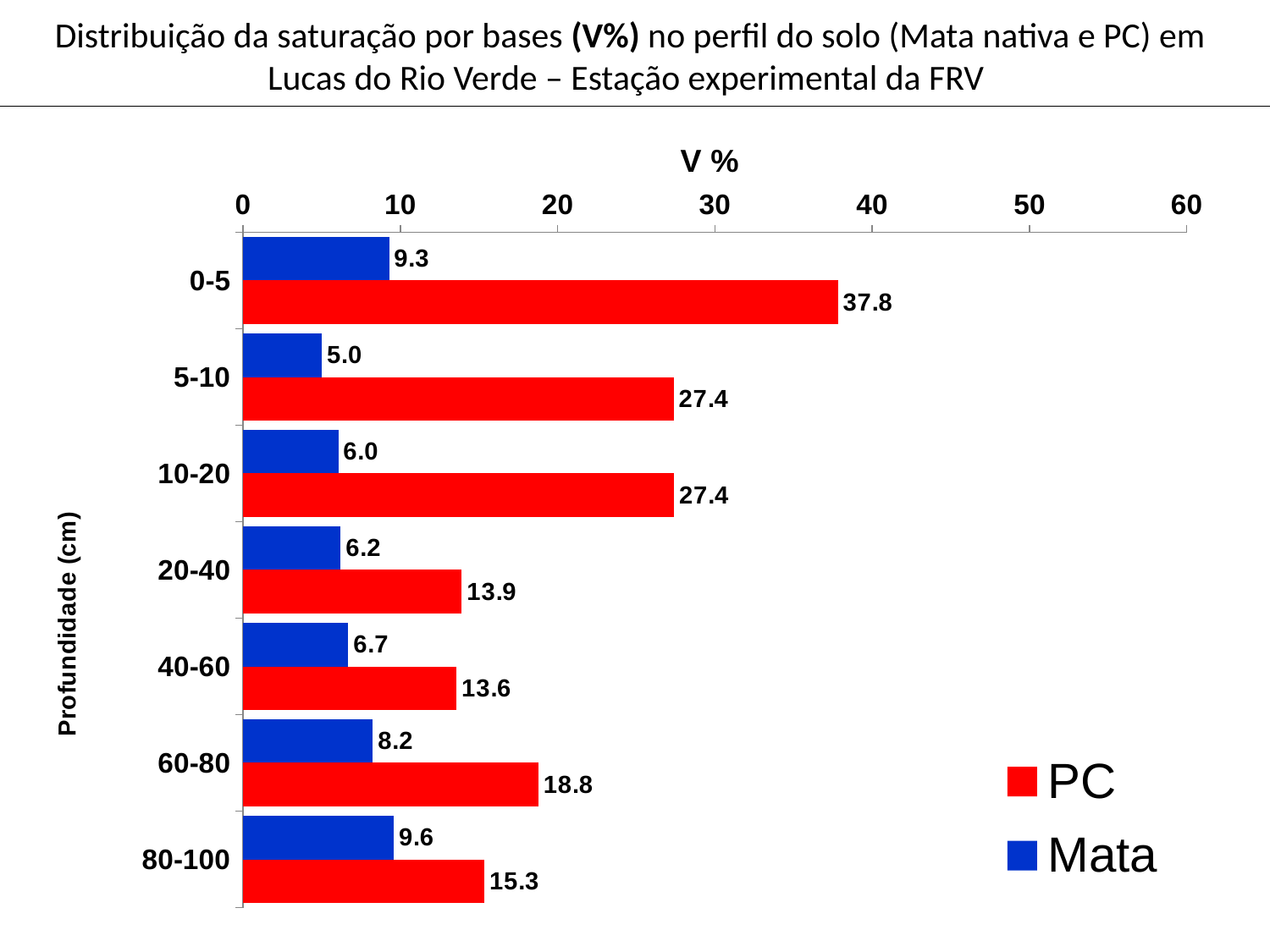
What colour represents the Mata series in the chart? blue What is the difference between the PC and Mata values at the 0-5 cm depth? 28.5 How many depth categories are shown on the chart? 7 What is the V% value for PC at the 60-80 cm depth? 18.8 Which depth has the highest V% value for PC? 0-5 What is the V% value for PC at the 0-5 cm depth? 37.8 Which depth has the lowest V% value for Mata? 5-10 What kind of chart is shown on the slide? bar chart Which is larger at the 80-100 cm depth, the PC value or the Mata value? PC What is the V% value for Mata at the 5-10 cm depth? 5.0 Is the PC value at the 10-20 cm depth greater or less than 20? greater How many series does the legend list? 2